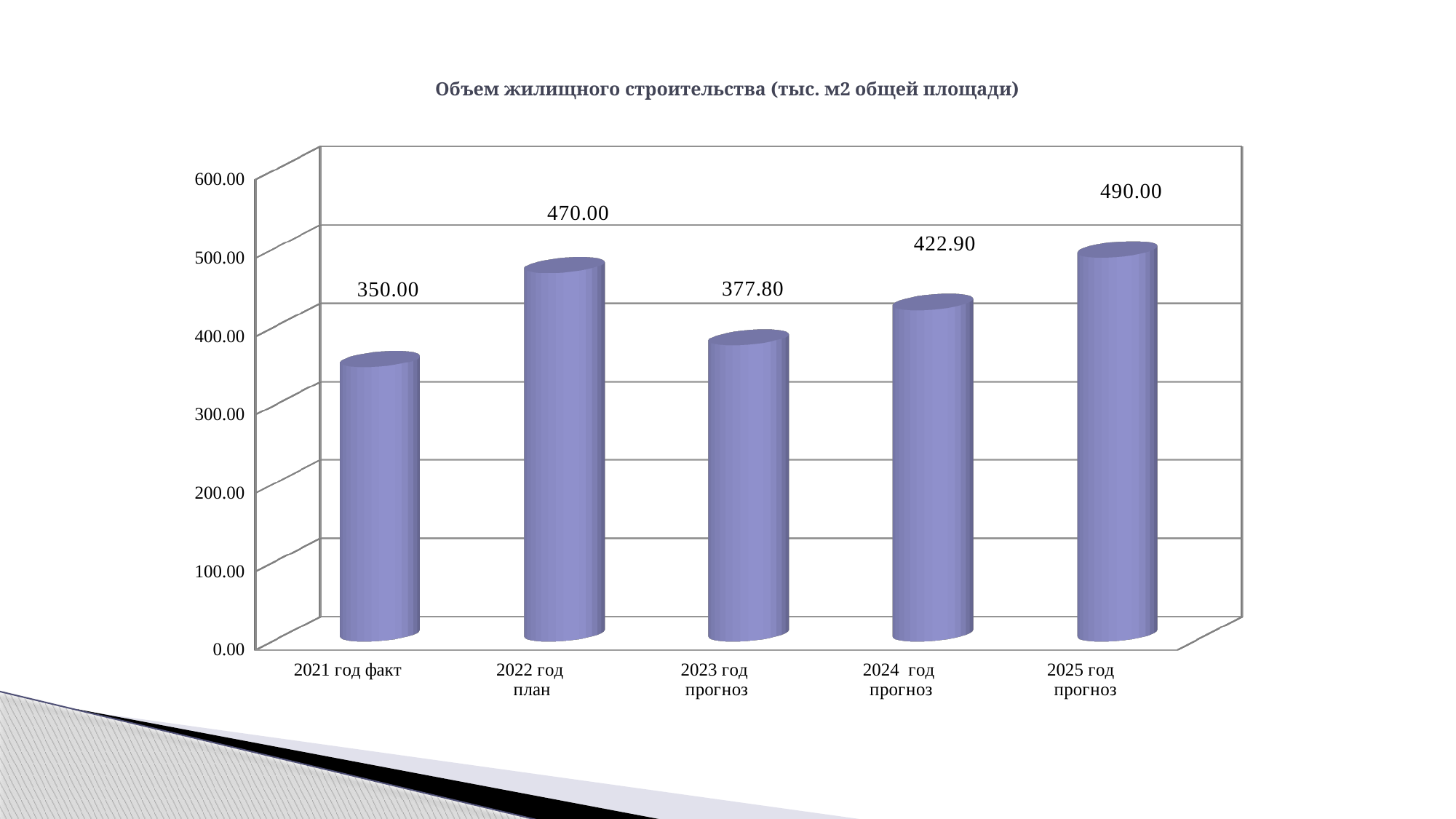
Which category has the highest value? 2025 год прогноз Which category has the lowest value? 2021 год факт Which is larger, the value for 2022 год план or the value for 2023 год прогноз? 2022 год план How many categories are shown on the x axis? 5 Is the value for 2024 год прогноз greater or less than 400.00? greater What is the difference between the values for 2025 год прогноз and 2021 год факт? 140.00 What is the value for 2023 год прогноз? 377.80 What is the value for 2021 год факт? 350.00 What is the value for 2022 год план? 470.00 What is the value for 2024 год прогноз? 422.90 What is the title of the chart? Объем жилищного строительства (тыс. м2 общей площади) What kind of chart is shown on the slide? bar chart